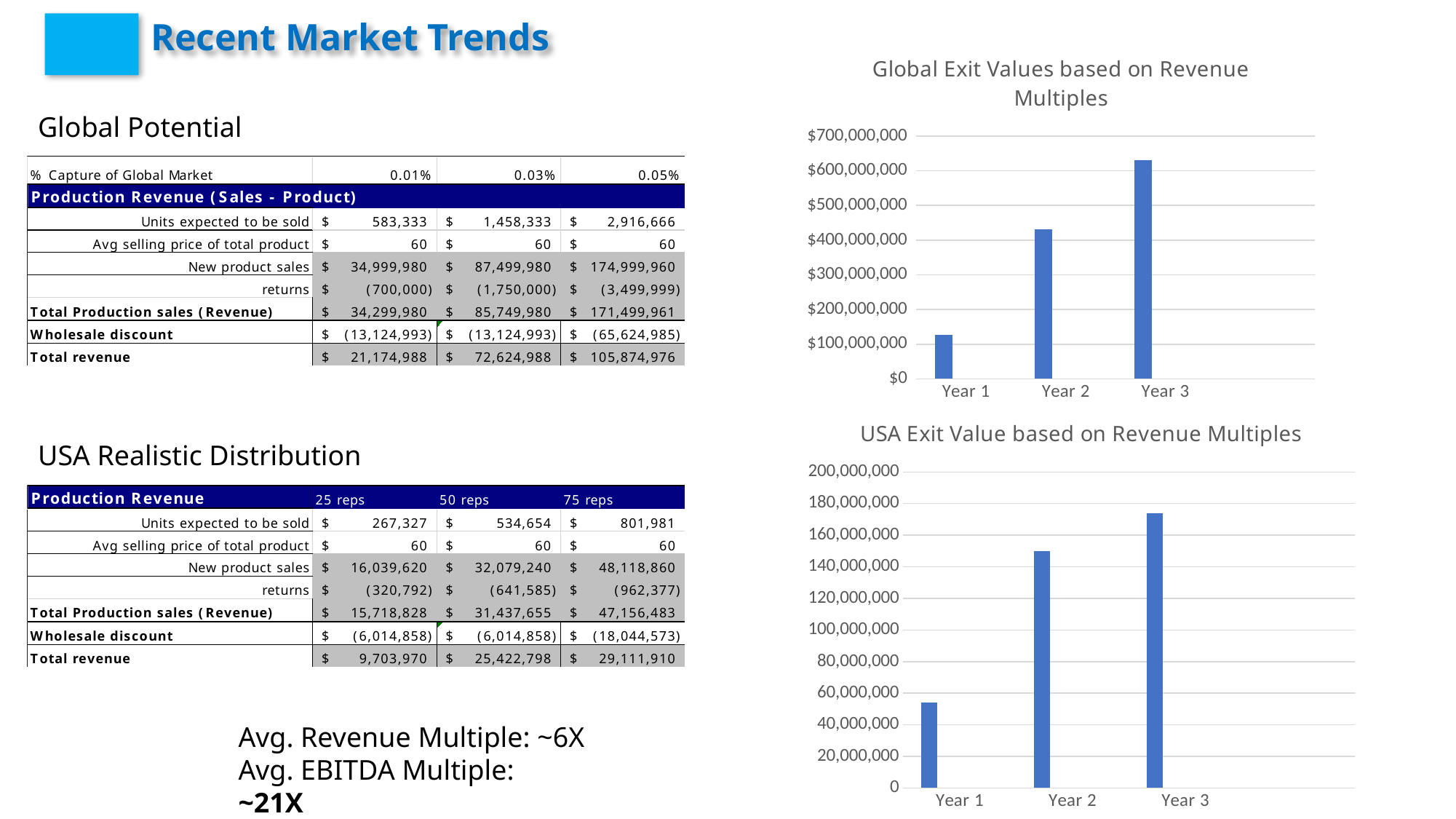
In the 'USA Exit Value based on Revenue Multiples' chart, which year has the highest value? Year 3 In the 'Global Exit Values based on Revenue Multiples' chart, do the values rise or fall from Year 1 to Year 3? rise In the 'Global Exit Values based on Revenue Multiples' chart, which year has the lowest value? Year 1 In the 'USA Exit Value based on Revenue Multiples' chart, is the value for Year 1 greater or less than 60,000,000? less In the 'Global Exit Values based on Revenue Multiples' chart, is the value for Year 3 greater or less than $600,000,000? greater In the 'Global Exit Values based on Revenue Multiples' chart, how many categories are shown on the x axis? 3 In the 'USA Exit Value based on Revenue Multiples' chart, which is larger, the value for Year 1 or the value for Year 2? Year 2 In the 'Global Exit Values based on Revenue Multiples' chart, which year has the highest value? Year 3 What is the title of the lower chart on the right side of the slide? USA Exit Value based on Revenue Multiples In the 'USA Exit Value based on Revenue Multiples' chart, is the value for Year 3 greater or less than 160,000,000? greater What kind of chart is the 'Global Exit Values based on Revenue Multiples' chart? bar chart